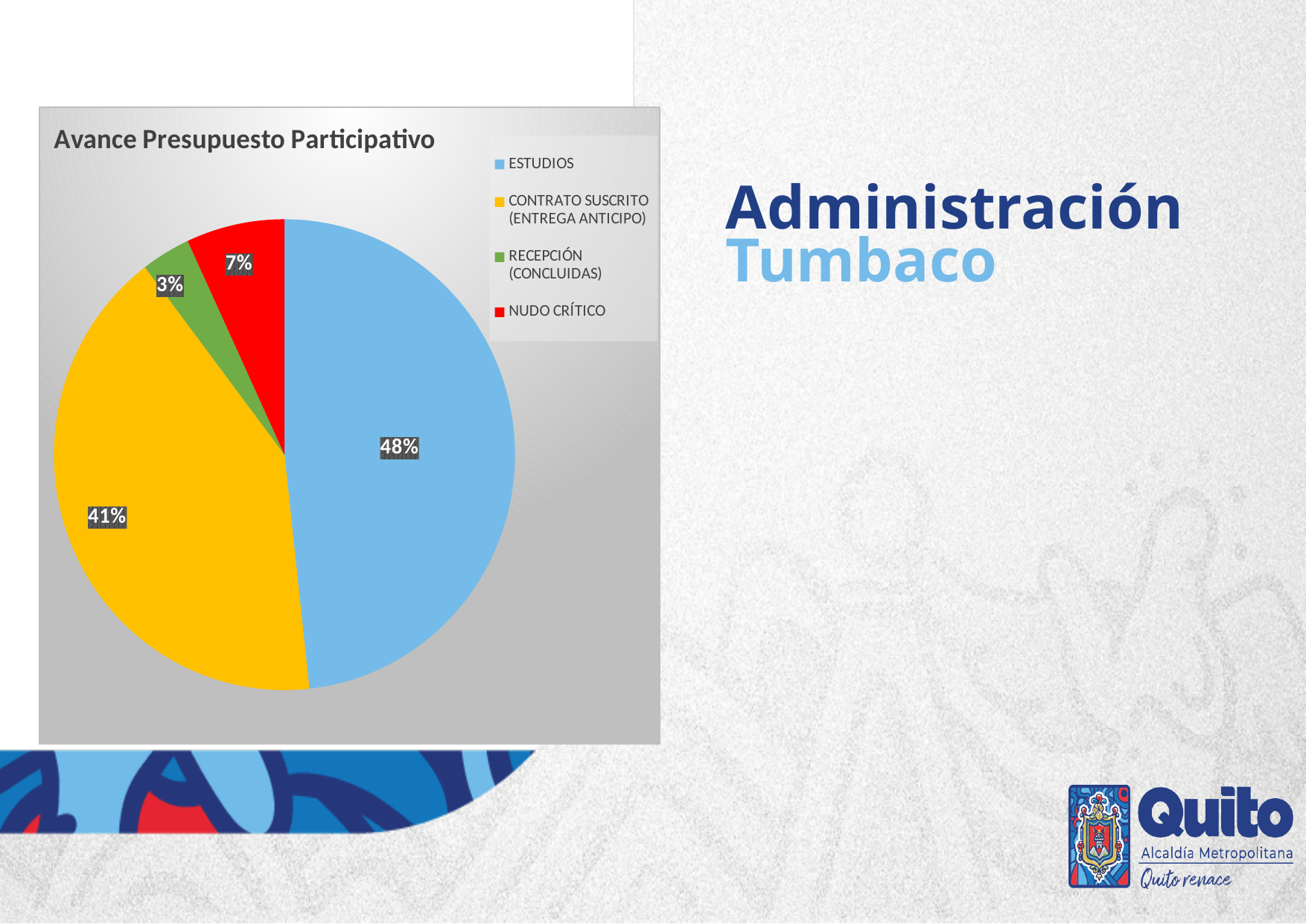
What is the title of the chart? Avance Presupuesto Participativo What percentage of the pie does RECEPCIÓN (CONCLUIDAS) represent? 3% Which category has the largest share of the pie? ESTUDIOS What percentage of the pie does ESTUDIOS represent? 48% Which category has the smallest share of the pie? RECEPCIÓN (CONCLUIDAS) What type of chart is shown on the slide? Pie chart What percentage of the pie does CONTRATO SUSCRITO (ENTREGA ANTICIPO) represent? 41% What percentage of the pie does NUDO CRÍTICO represent? 7% How many categories does the pie chart have? 4 Which is larger, the share for NUDO CRÍTICO or the share for RECEPCIÓN (CONCLUIDAS)? NUDO CRÍTICO What colour is the slice for NUDO CRÍTICO? Red What is the difference in percentage points between ESTUDIOS and CONTRATO SUSCRITO (ENTREGA ANTICIPO)? 7